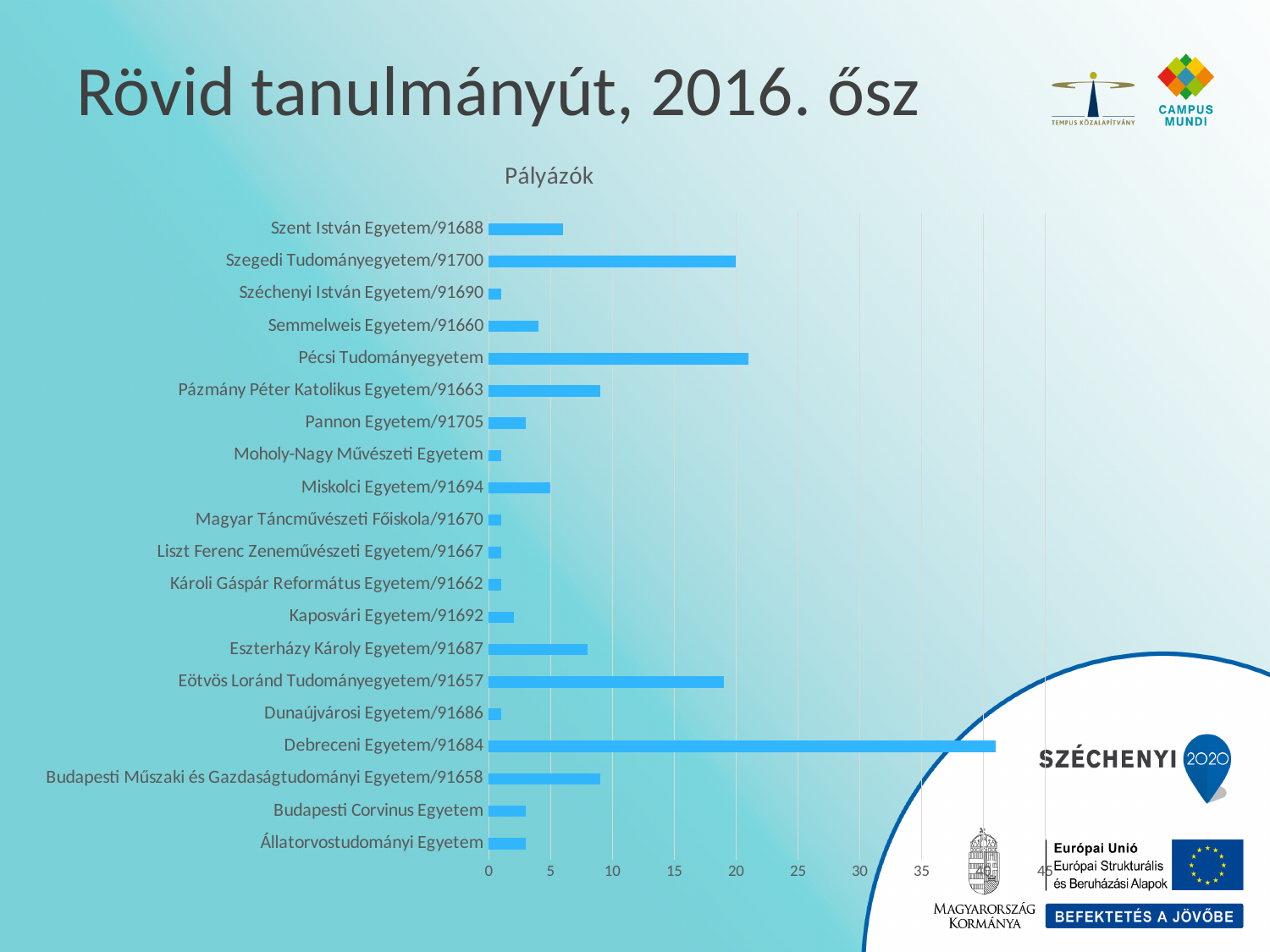
What is the title of the chart? Pályázók Which has a larger value, Debreceni Egyetem/91684 or Szegedi Tudományegyetem/91700? Debreceni Egyetem/91684 Which university has the highest value in the chart? Debreceni Egyetem/91684 Is the value for Pázmány Péter Katolikus Egyetem/91663 greater or less than 10? less Is the value for Pécsi Tudományegyetem greater or less than 20? greater What kind of chart is shown on the slide? bar chart Which has a larger value, Pécsi Tudományegyetem or Szent István Egyetem/91688? Pécsi Tudományegyetem Is the value for Semmelweis Egyetem/91660 greater or less than 5? less Which has a larger value, Eszterházy Károly Egyetem/91687 or Kaposvári Egyetem/91692? Eszterházy Károly Egyetem/91687 How many universities (categories) are listed in the chart? 20